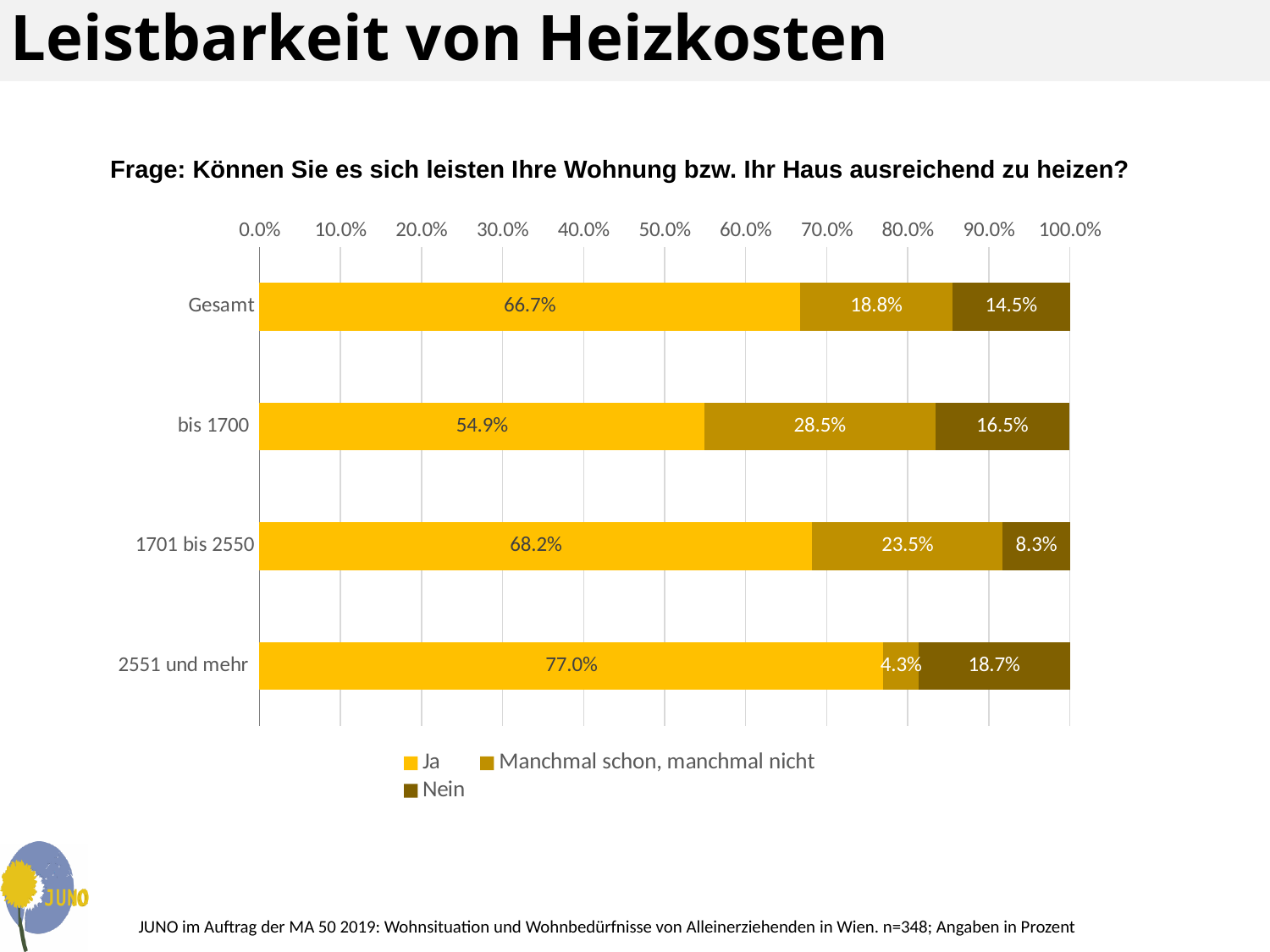
What kind of chart is shown on the slide? Stacked bar chart How many series does the legend list? 3 What is the "Manchmal schon, manchmal nicht" value for "2551 und mehr"? 4.3% What is the difference between the "Ja" values for "2551 und mehr" and "bis 1700"? 22.1% What is the total of the stacked bar for "1701 bis 2550"? 100.0% Which category has the highest "Ja" value? 2551 und mehr How many categories are shown on the y axis of the chart? 4 Which is larger: the "Nein" value for "Gesamt" or the "Nein" value for "bis 1700"? bis 1700 What is the "Ja" value for the category "bis 1700"? 54.9% What is the "Ja" value for "Gesamt"? 66.7% Which category has the lowest "Nein" value? 1701 bis 2550 What is the "Nein" value for the category "1701 bis 2550"? 8.3%